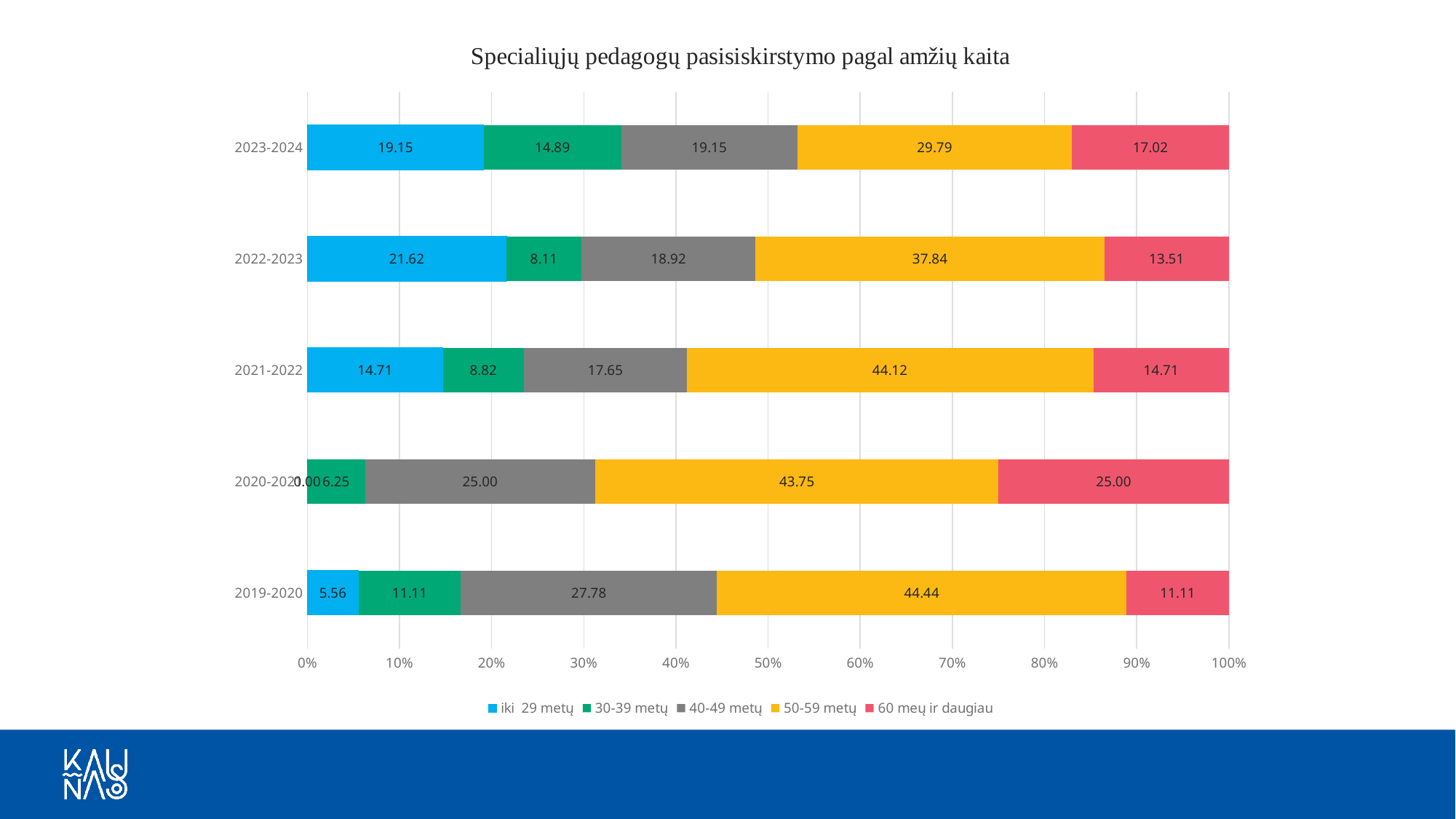
Which school year has the highest value for 50-59 metų? 2019-2020 What is the value for iki 29 metų in 2022-2023? 21.62 What is the title of the chart? Specialiųjų pedagogų pasisiskirstymo pagal amžių kaita What is the difference between the 50-59 metų and 60 meų ir daugiau values in 2023-2024? 12.77 How many series does the legend list? 5 In 2022-2023, which is larger: iki 29 metų or 40-49 metų? iki 29 metų What is the difference between the 50-59 metų and 40-49 metų values in 2021-2022? 26.47 Which school year has the lowest value for 60 meų ir daugiau? 2019-2020 What kind of chart is shown on the slide? Stacked bar chart How many school years are shown on the chart? 5 What is the value for 40-49 metų in 2019-2020? 27.78 What is the value for 50-59 metų in 2023-2024? 29.79